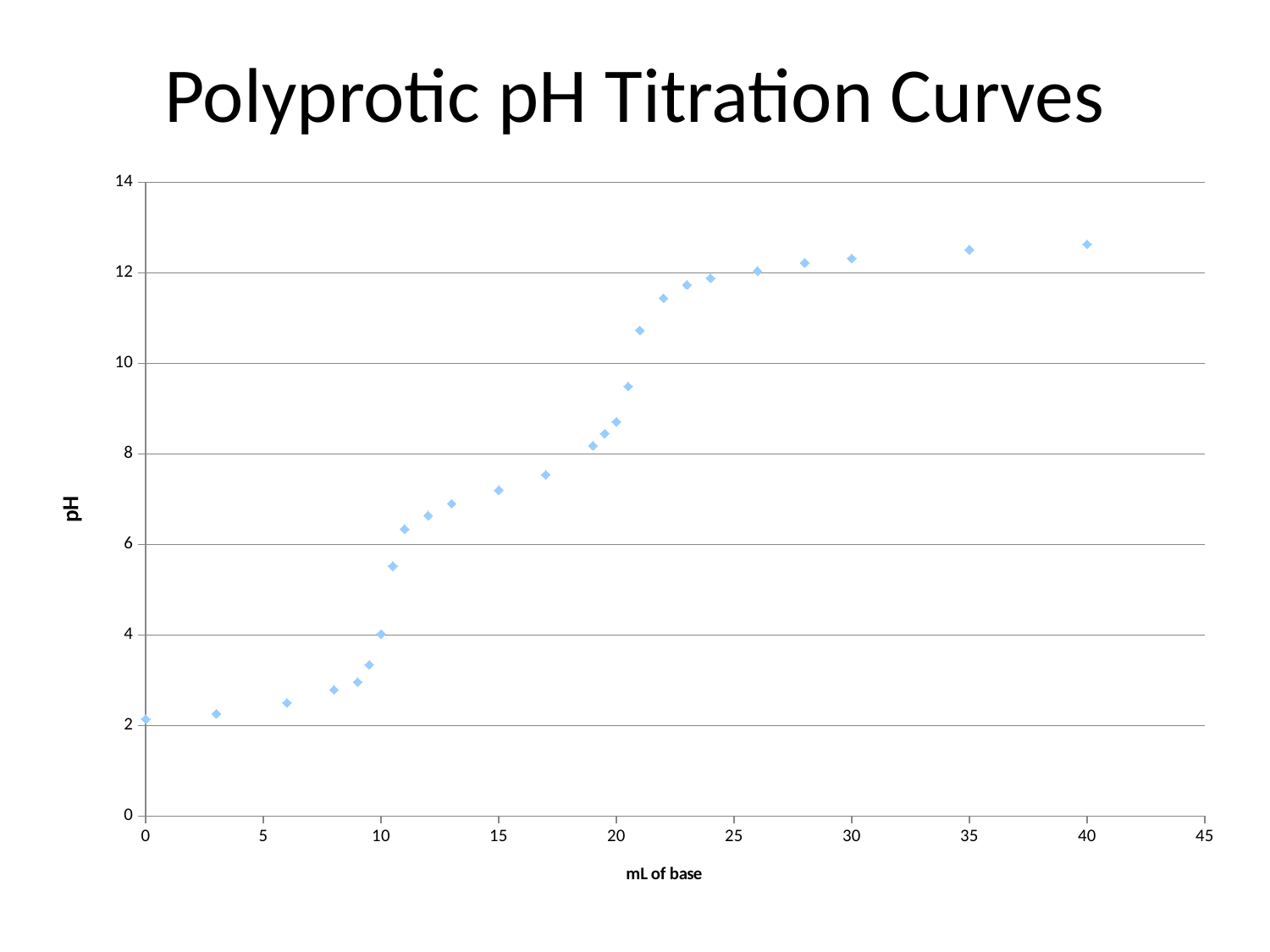
Is the pH at 20 mL of base greater or less than 8? greater What is the title of the chart? Polyprotic pH Titration Curves What kind of chart is shown on the slide? scatter chart Which has the lower pH: 3 mL of base or 13 mL of base? 3 mL of base Which has the higher pH: 10 mL of base or 20 mL of base? 20 mL of base What is the label on the x axis of the chart? mL of base Is the pH at 10 mL of base greater or less than 6? less Is the pH at 40 mL of base greater or less than 12? greater Does the pH rise or fall as mL of base increases along the x axis? rise